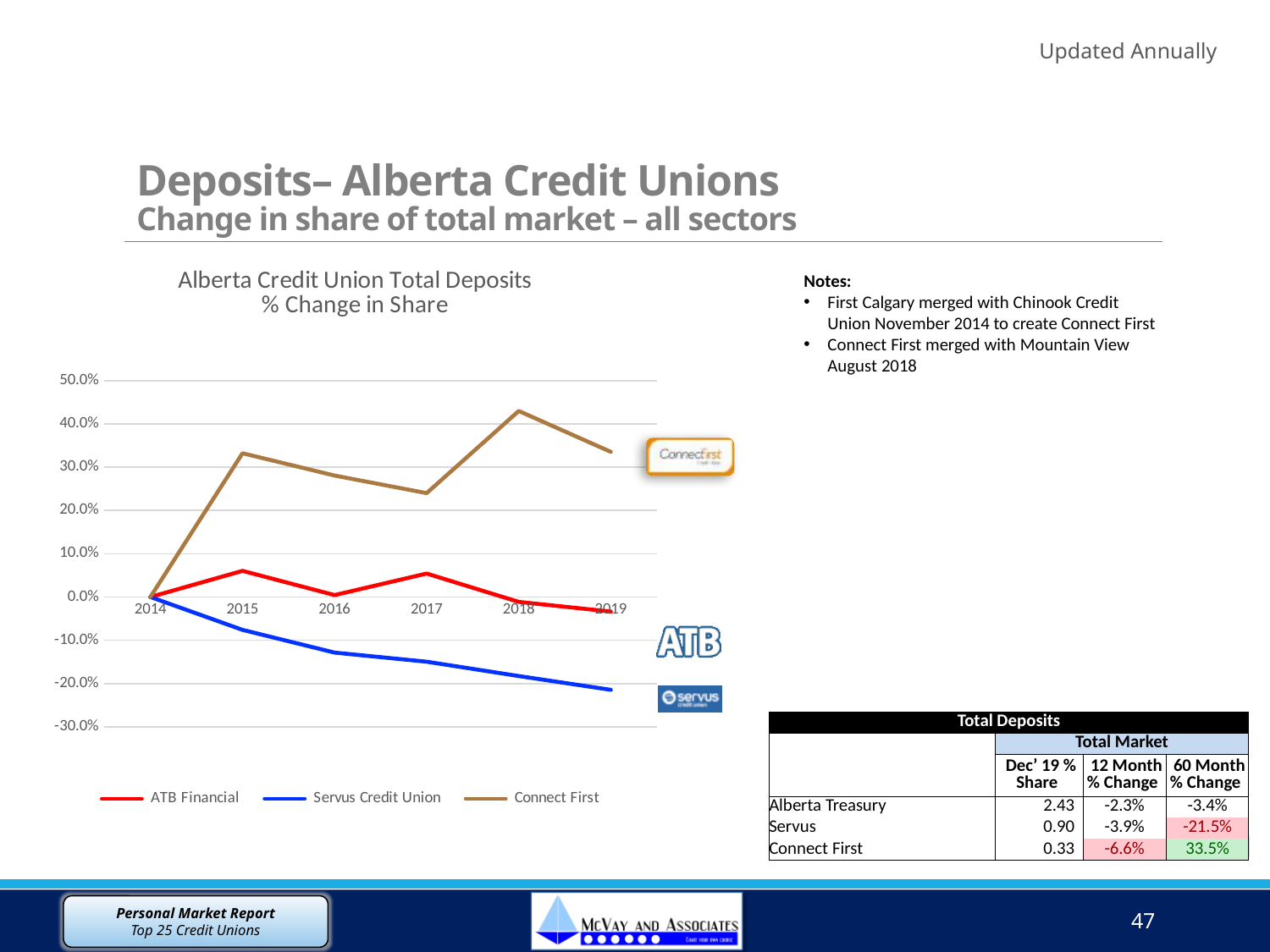
How many series does the chart legend list? 3 How many years are plotted along the x axis of the chart? 6 Which series has the highest value in 2018? Connect First Is the value for Servus Credit Union in 2016 greater or less than -10.0%? less Does the Servus Credit Union line rise or fall from 2014 to 2019? fall Is the value for Connect First in 2018 greater or less than 40.0%? greater What is the title of the chart? Alberta Credit Union Total Deposits % Change in Share Which series has the lowest value in 2019? Servus Credit Union Is the value for Connect First in 2017 greater or less than 20.0%? greater What kind of chart is shown on the slide? line chart In 2017, which is larger: the value for ATB Financial or the value for Servus Credit Union? ATB Financial What is the value for Connect First in 2014? 0.0%